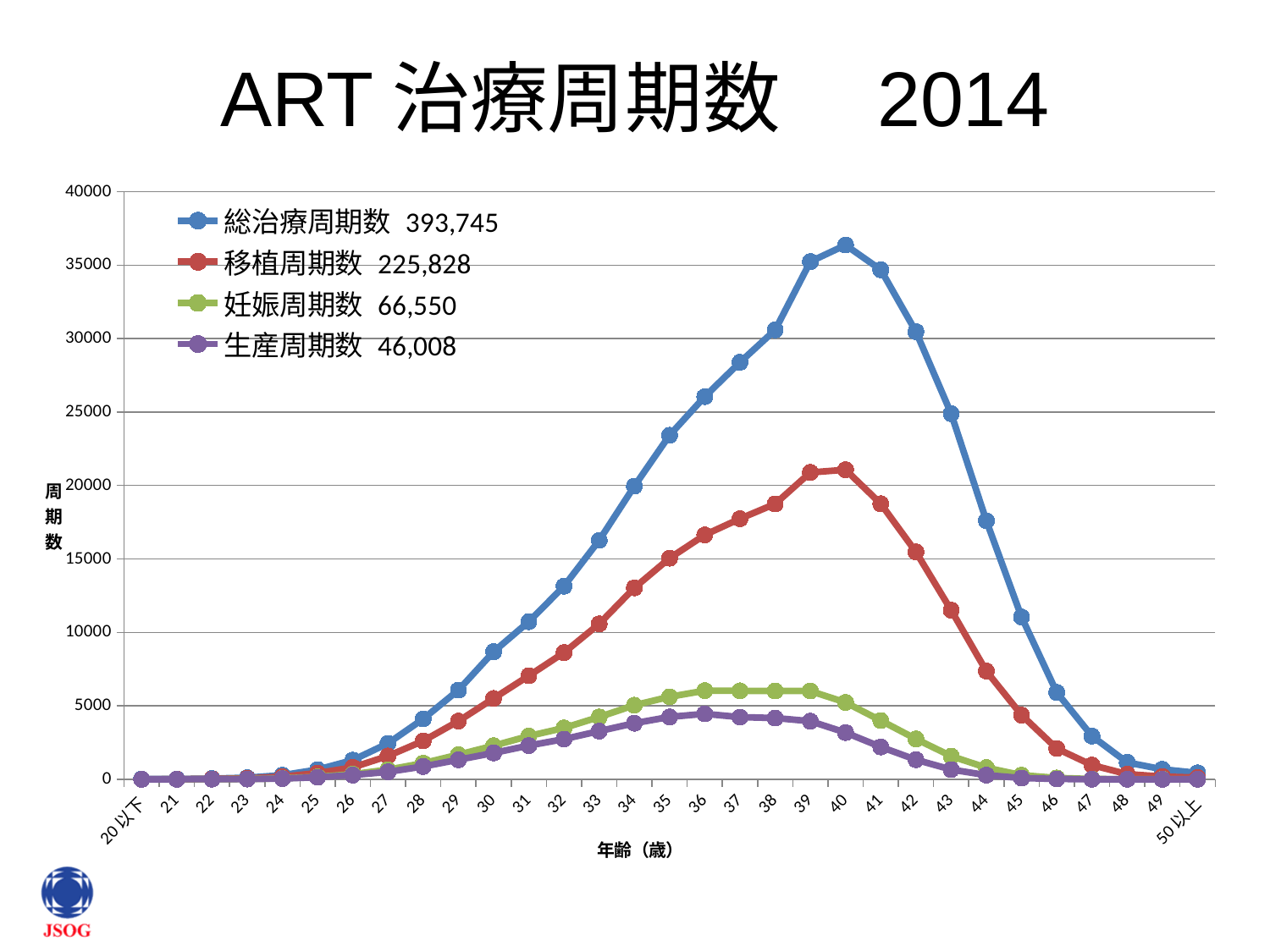
What total is printed next to 移植周期数 in the legend? 225,828 Does the 総治療周期数 series rise or fall from age 40 to 50以上? fall Is the value of 総治療周期数 at age 40 greater or less than 35000? greater What kind of chart is shown on the slide? line chart How many age categories are plotted along the x axis? 31 What total is printed next to 生産周期数 in the legend? 46,008 What total is printed next to 総治療周期数 in the legend? 393,745 Is the value of 移植周期数 at age 38 greater or less than 20000? less Is the value of 生産周期数 at age 36 greater or less than 5000? less How many series does the legend list? 4 What total is printed next to 妊娠周期数 in the legend? 66,550 At which age does the 総治療周期数 series reach its highest value? 40